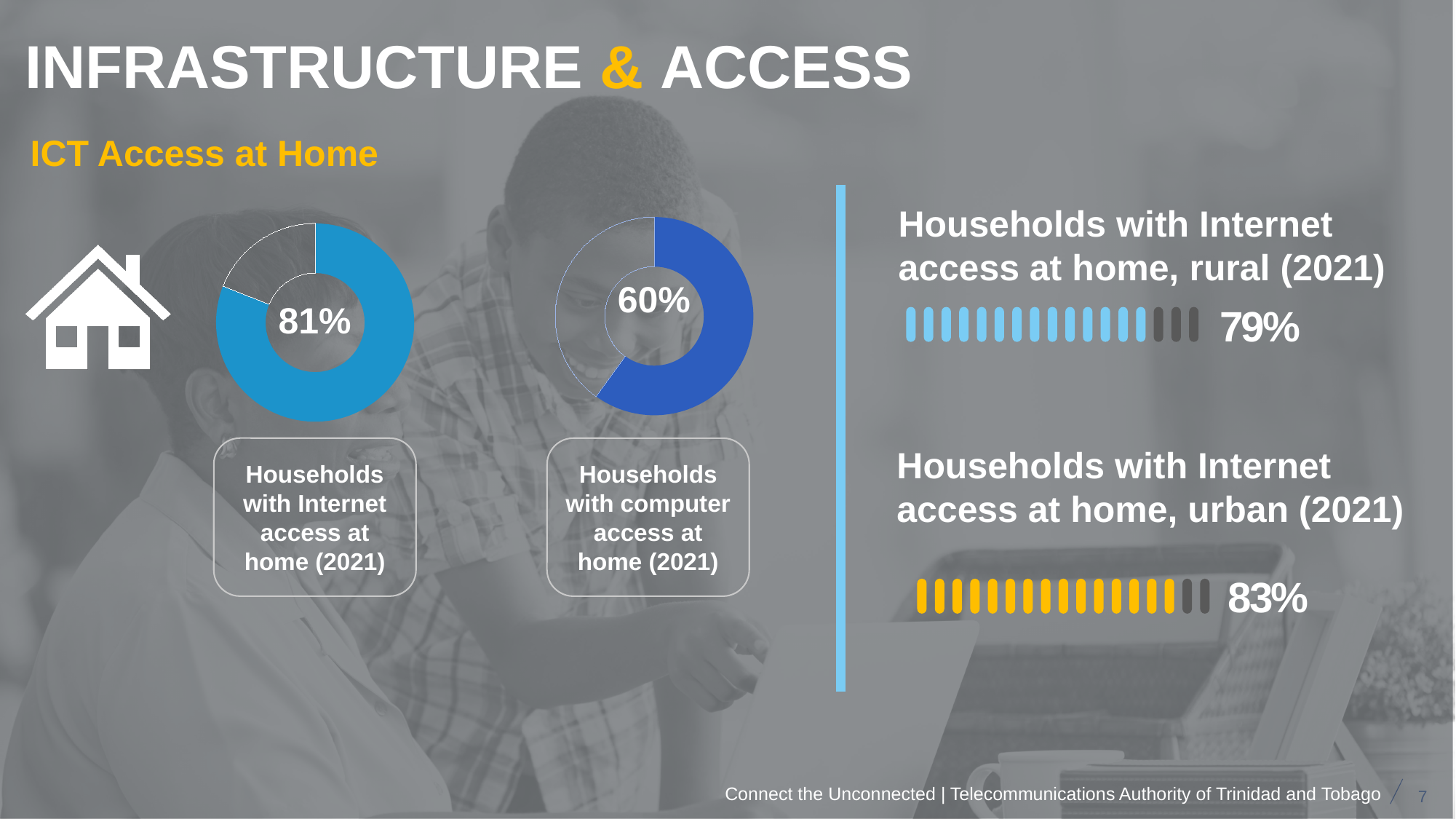
What is the share of households with Internet access at home in urban areas (2021), shown on the right side of the slide? 83% Which is higher: households with Internet access at home (2021) or households with computer access at home (2021)? Households with Internet access at home What colour is the filled portion of the donut chart showing households with computer access at home? Blue What kind of chart is used to show the 81% of households with Internet access at home? Donut (pie) chart Which area has the higher share of households with Internet access at home in 2021, rural or urban? Urban What is the subtitle of the slide above the charts? ICT Access at Home What is the difference in percentage points between urban (83%) and rural (79%) households with Internet access at home in 2021? 4 What percentage of households had Internet access at home in 2021, according to the left donut chart? 81% What is the share of households with Internet access at home in rural areas (2021), shown on the right side of the slide? 79% What is the difference in percentage points between households with Internet access at home (81%) and households with computer access at home (60%)? 21 How many donut charts are shown on the slide? 2 What percentage of households had computer access at home in 2021, according to the right donut chart? 60%